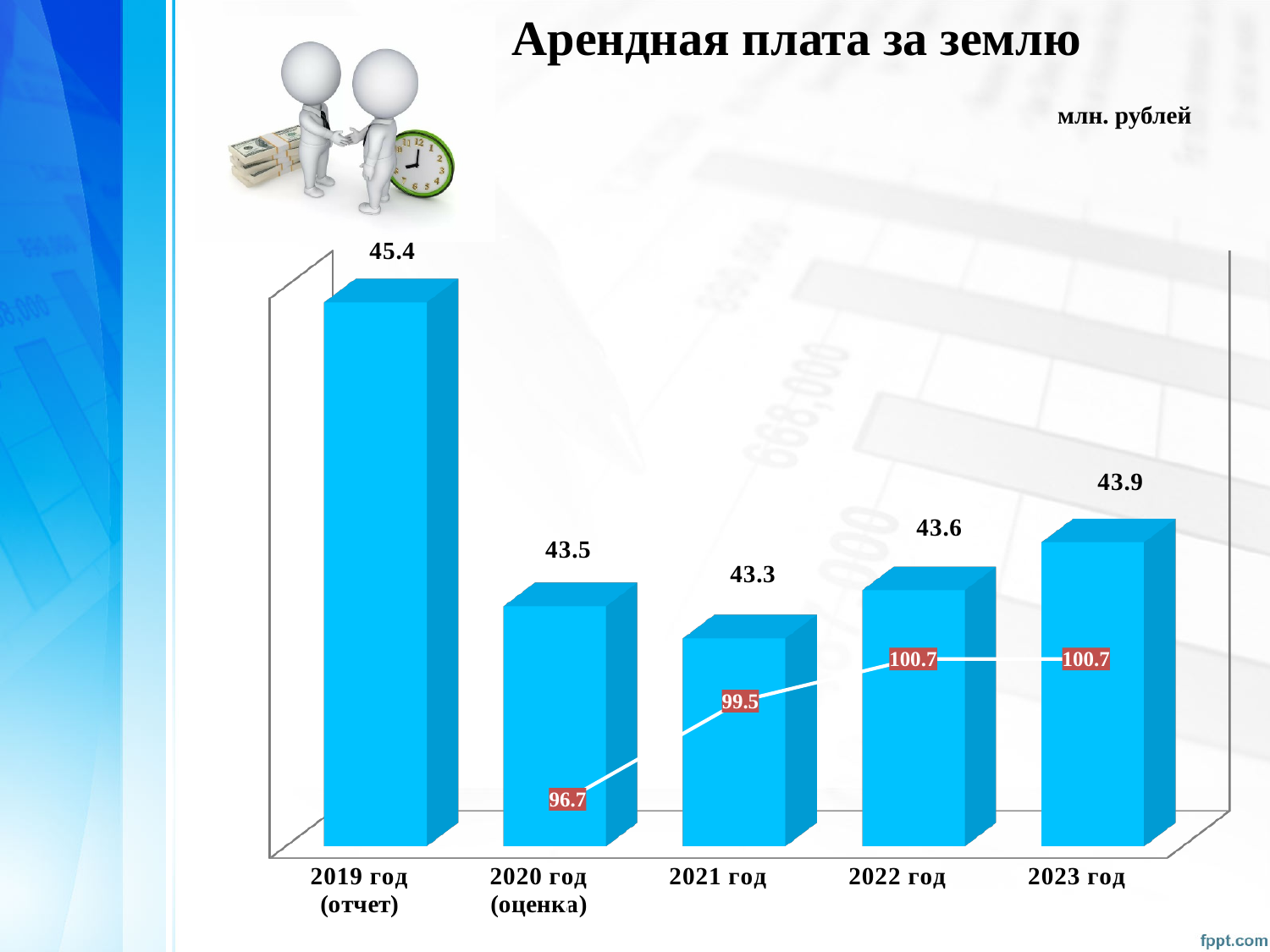
Which bar is larger: 2022 год or 2023 год? 2023 год Which year has the lowest bar value? 2021 год How many years are shown on the x axis? 5 Which year has the highest bar value? 2019 год (отчет) What is the difference between the bar values for 2019 год (отчет) and 2020 год (оценка)? 1.9 What is the line value shown for 2020 год (оценка)? 96.7 What is the title of the chart? Арендная плата за землю What is the line value shown for 2022 год? 100.7 What type of chart is used for the main data series? Bar chart What is the value of the bar for 2019 год (отчет)? 45.4 What is the value of the bar for 2021 год? 43.3 What is the value of the bar for 2023 год? 43.9